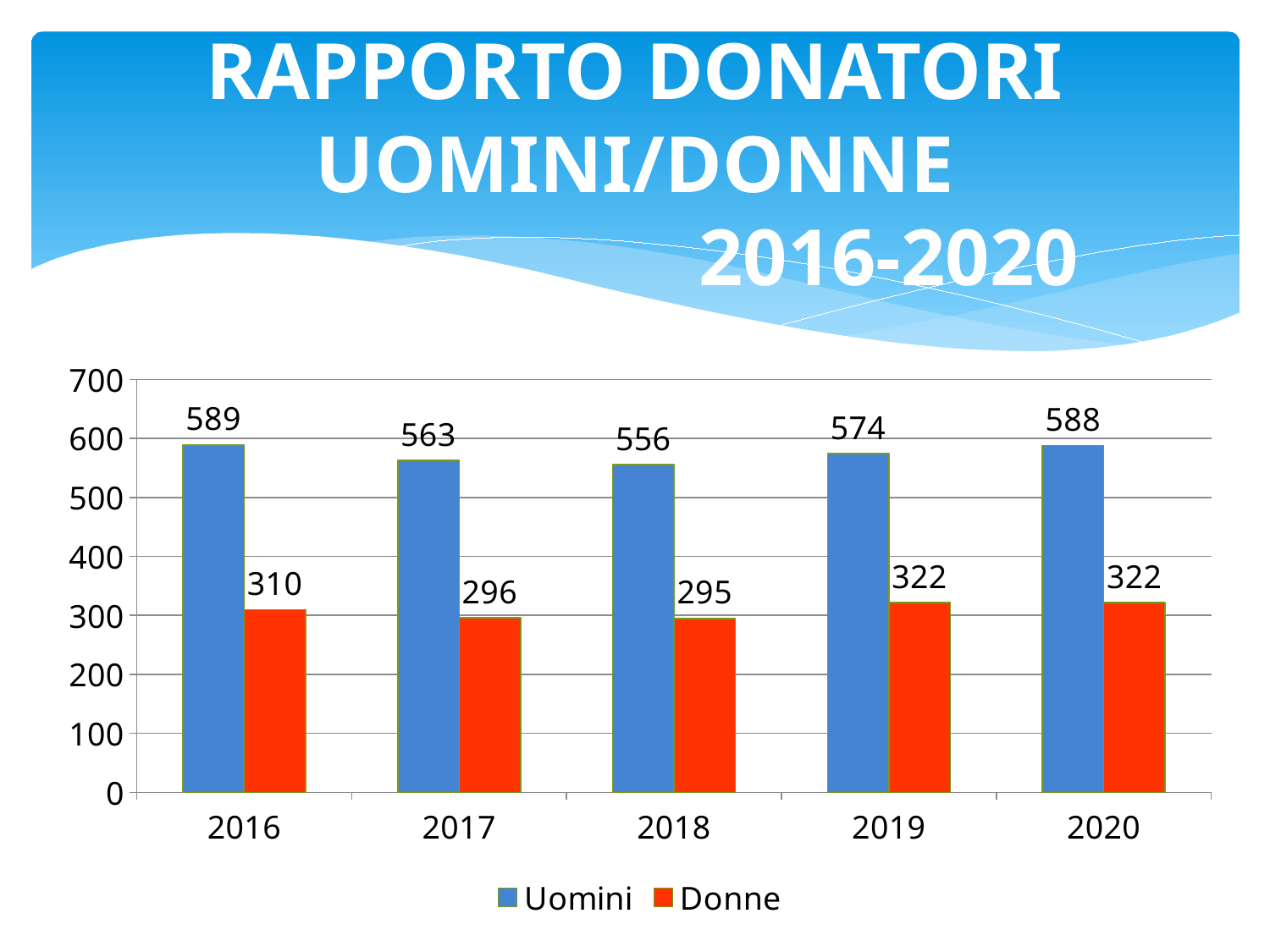
What is the value for Uomini in 2016? 589 In which year is the Uomini value highest? 2016 How many series does the legend list? 2 What is the difference between the Uomini and Donne values in 2019? 252 Which is larger, the Donne value in 2016 or the Donne value in 2017? Donne in 2016 What is the value for Uomini in 2020? 588 What kind of chart is shown on the slide? bar chart How many years are shown on the x axis? 5 Is the value for Donne in 2020 greater or less than 300? greater What is the value for Donne in 2018? 295 In which year is the Uomini value lowest? 2018 Which colour represents the Donne series? red